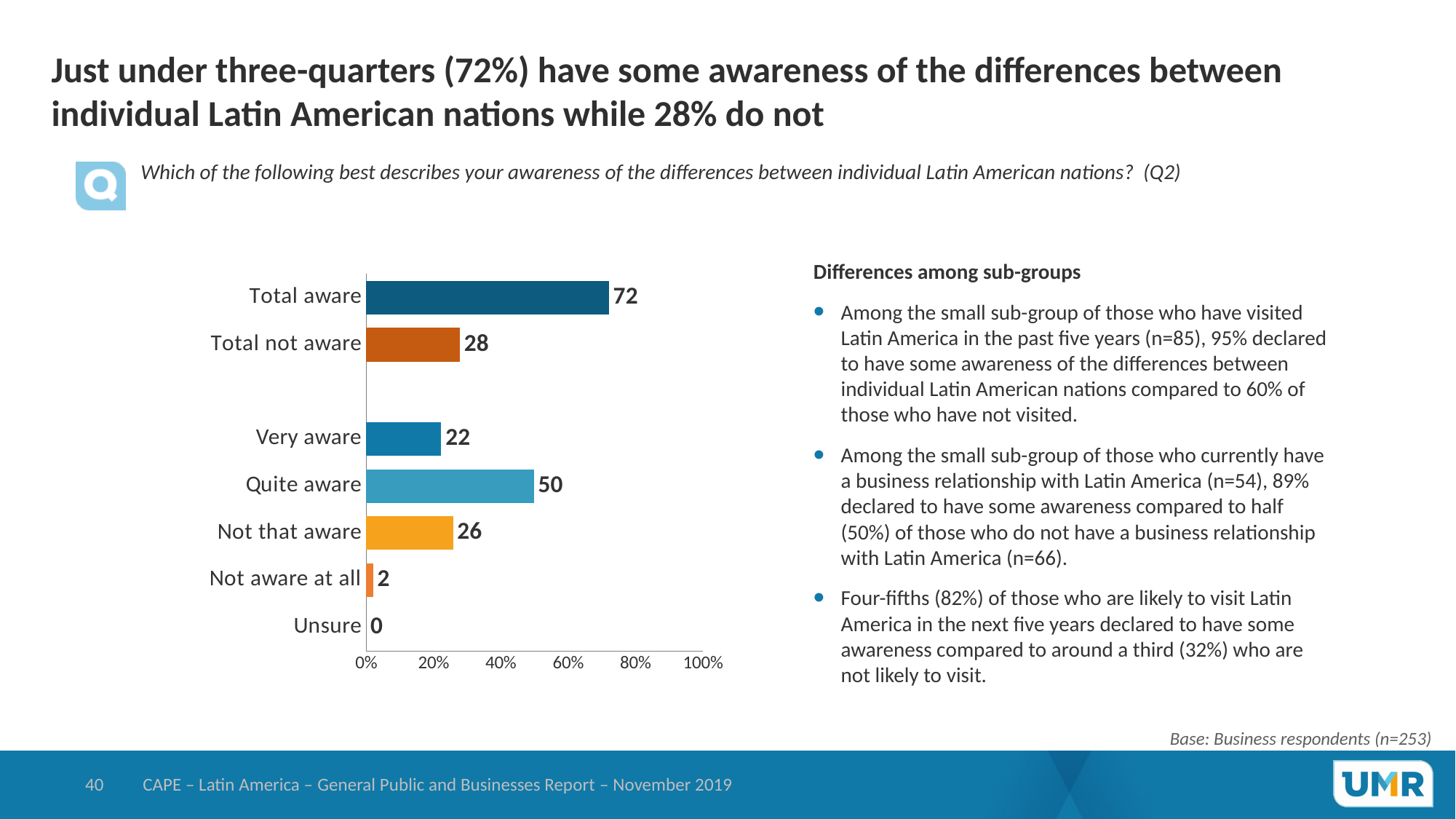
What is the value for Quite aware? 50 Which category has the lowest value? Unsure Is the value for Quite aware greater or less than 40%? greater How many categories are shown on the chart? 7 What is the value for Total aware? 72 What is the highest value shown on the x axis? 100% Which is larger, Very aware or Not that aware? Not that aware What kind of chart is shown on the slide? Bar chart Which category has the highest value? Total aware What is the value for Unsure? 0 What is the difference between Total aware and Total not aware? 44 What is the value for Not that aware? 26